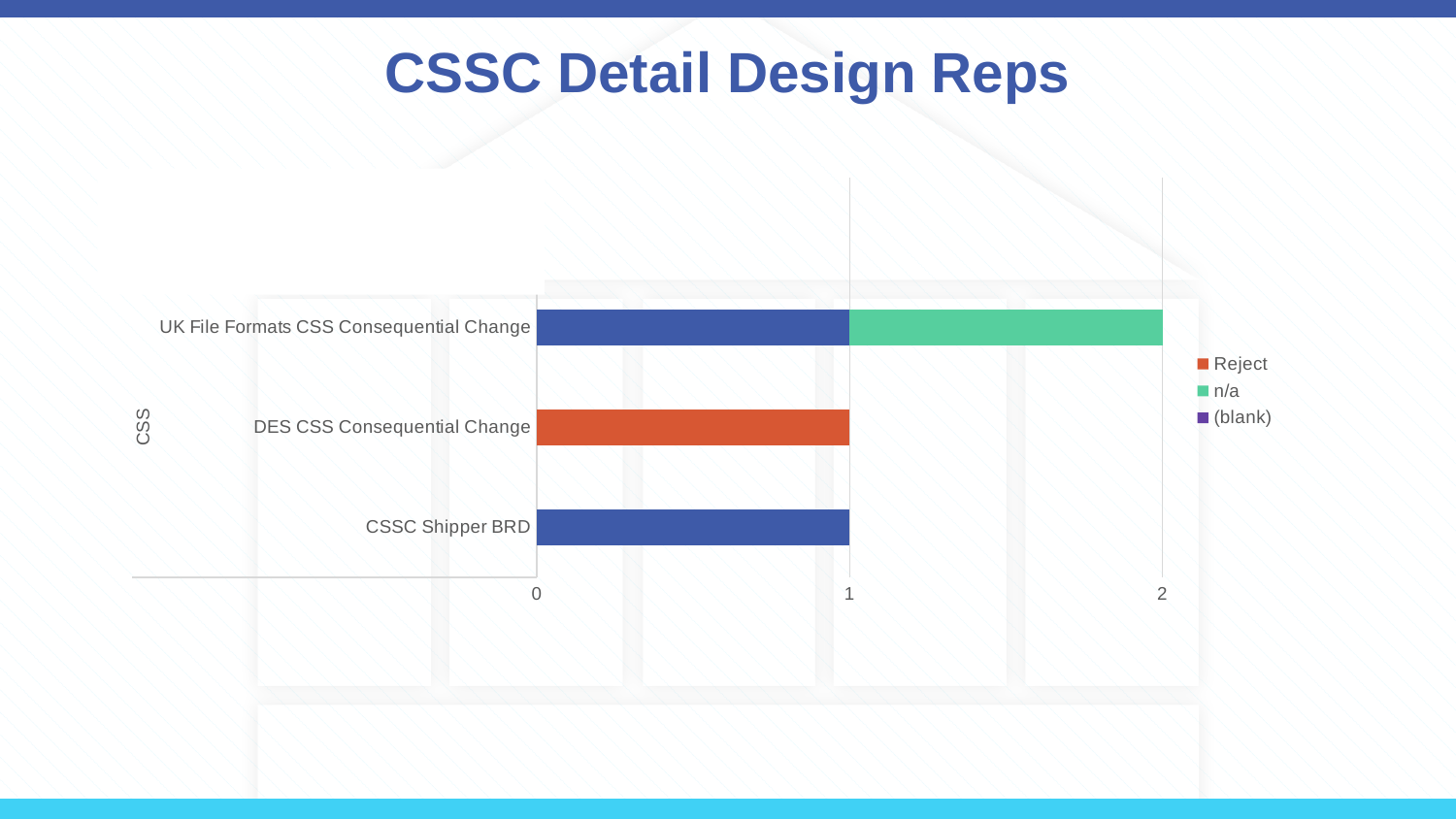
How many categories are shown on the vertical axis of the chart? 3 What kind of chart is shown on the slide? Stacked bar chart What is the value of the n/a series for UK File Formats CSS Consequential Change? 1 What is the value of the Reject series for DES CSS Consequential Change? 1 What label is shown on the vertical axis of the chart? CSS How many series does the chart's legend list? 3 What is the difference between the total for UK File Formats CSS Consequential Change and the total for CSSC Shipper BRD? 1 What is the value of the (blank) series for CSSC Shipper BRD? 1 What is the total of the stacked bar for UK File Formats CSS Consequential Change? 2 What is the title of the chart on the slide? CSSC Detail Design Reps Which category is the only one with a Reject value? DES CSS Consequential Change Which category has the longest total bar? UK File Formats CSS Consequential Change